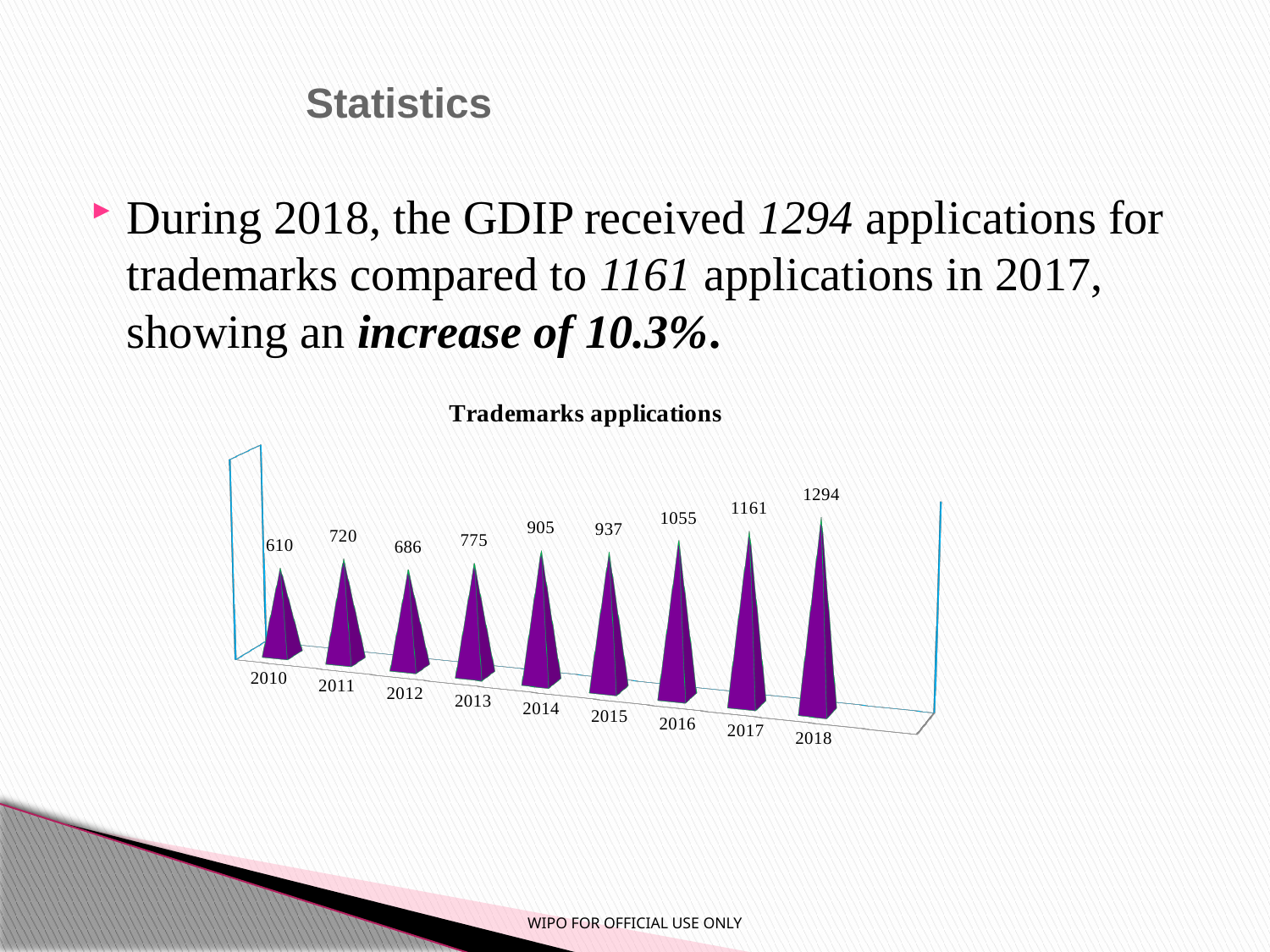
What kind of chart is shown on the slide? Bar chart Which is larger, the value for 2011 or the value for 2012? 2011 What is the value for 2010 in the Trademarks applications chart? 610 What is the title of the chart? Trademarks applications Which year has the lowest number of trademark applications? 2010 What is the difference between the values for 2018 and 2017? 133 Which year has the highest number of trademark applications? 2018 What is the value for 2014 in the Trademarks applications chart? 905 What is the difference between the values for 2011 and 2012? 34 Do the values generally rise or fall from 2012 to 2018? Rise How many years are shown in the Trademarks applications chart? 9 What is the value for 2016 in the Trademarks applications chart? 1055